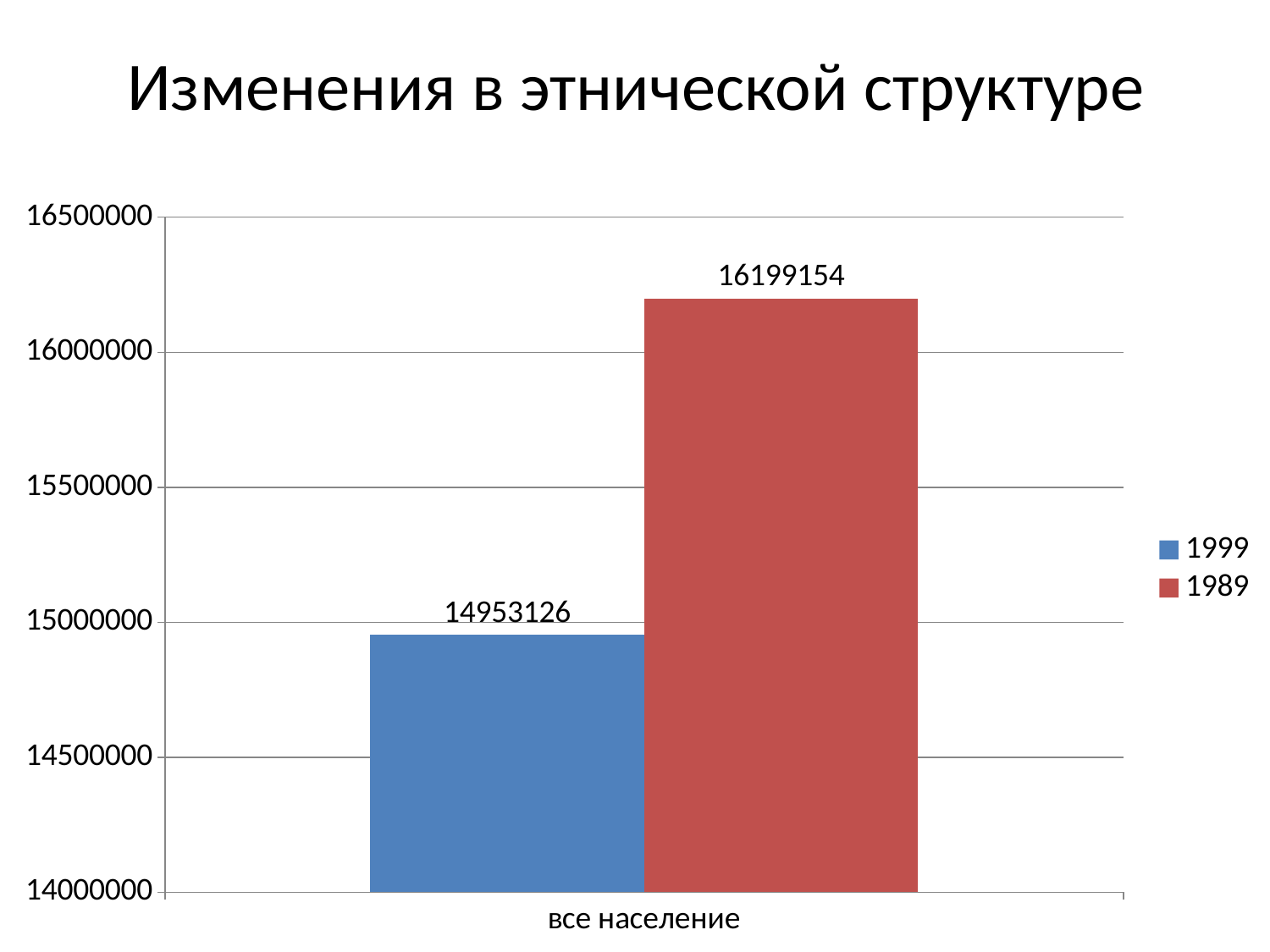
Is the value for 1999 greater or less than 15000000? less What kind of chart is shown on the slide? bar chart What is the value for the 1989 series for "все население"? 16199154 How many categories are shown on the x axis? 1 What is the value for the 1999 series for "все население"? 14953126 Is the value for 1989 greater or less than 16000000? greater Which series has the lowest value on the chart? 1999 What is the difference between the 1989 value and the 1999 value? 1246028 How many series does the legend list? 2 What is the title of the slide? Изменения в этнической структуре What colour is the bar for the 1989 series? red Which series has the higher value for "все население", 1999 or 1989? 1989